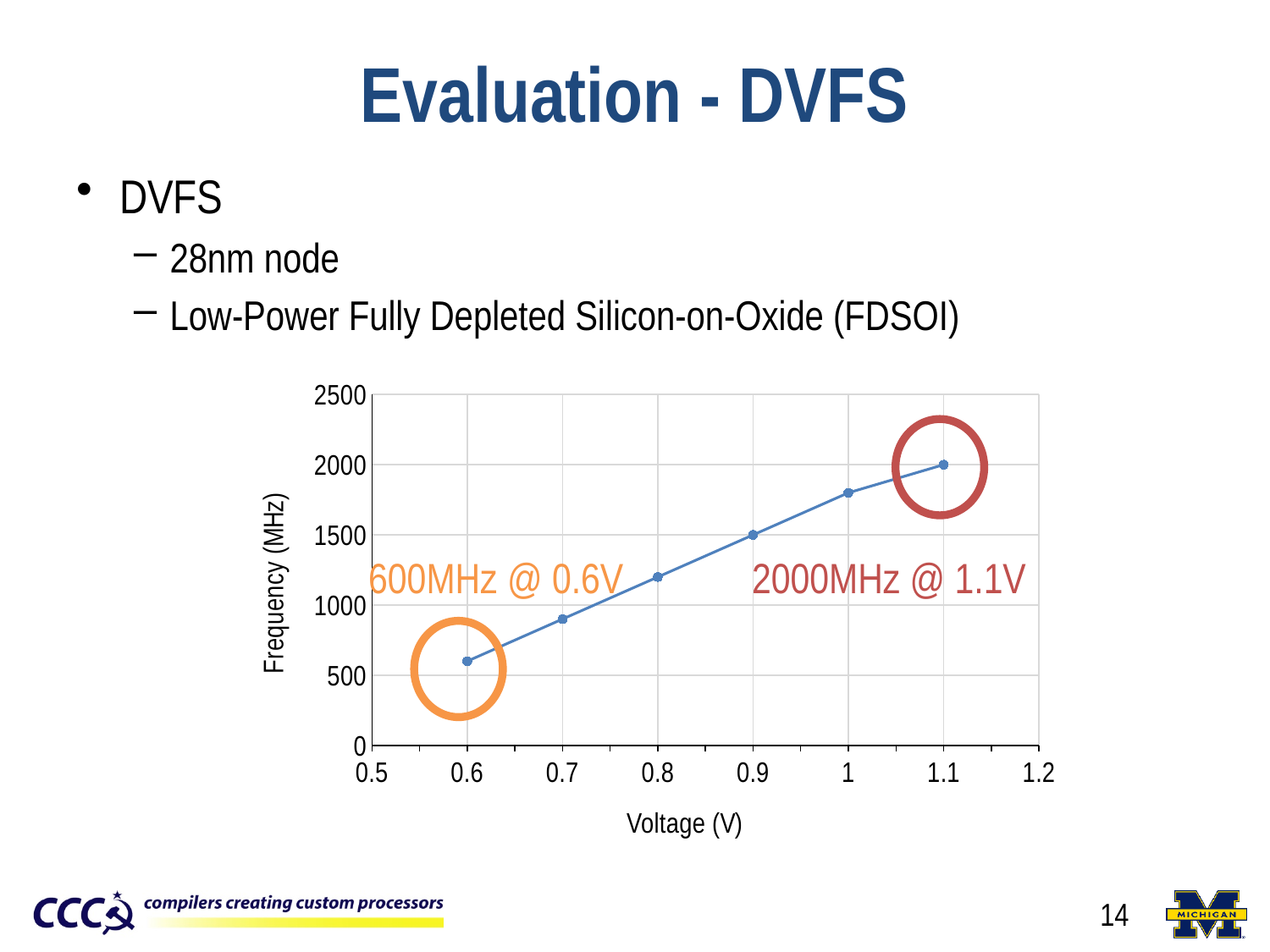
What is the label of the y axis? Frequency (MHz) What frequency is annotated at 0.6V? 600MHz What is the difference in frequency between the point at 1.1V and the point at 0.6V? 1400MHz Is the frequency at 1V greater or less than 1500 MHz? greater Which has a higher frequency, the point at 0.8V or the point at 1V? 1V What frequency is annotated at 1.1V? 2000MHz Does the frequency rise or fall as voltage increases along the x axis? rise At which voltage is the frequency highest? 1.1 Is the frequency at 0.7V greater or less than 1000 MHz? less What type of chart is shown on the slide? line chart How many data points are plotted on the chart? 6 At which voltage is the frequency lowest? 0.6